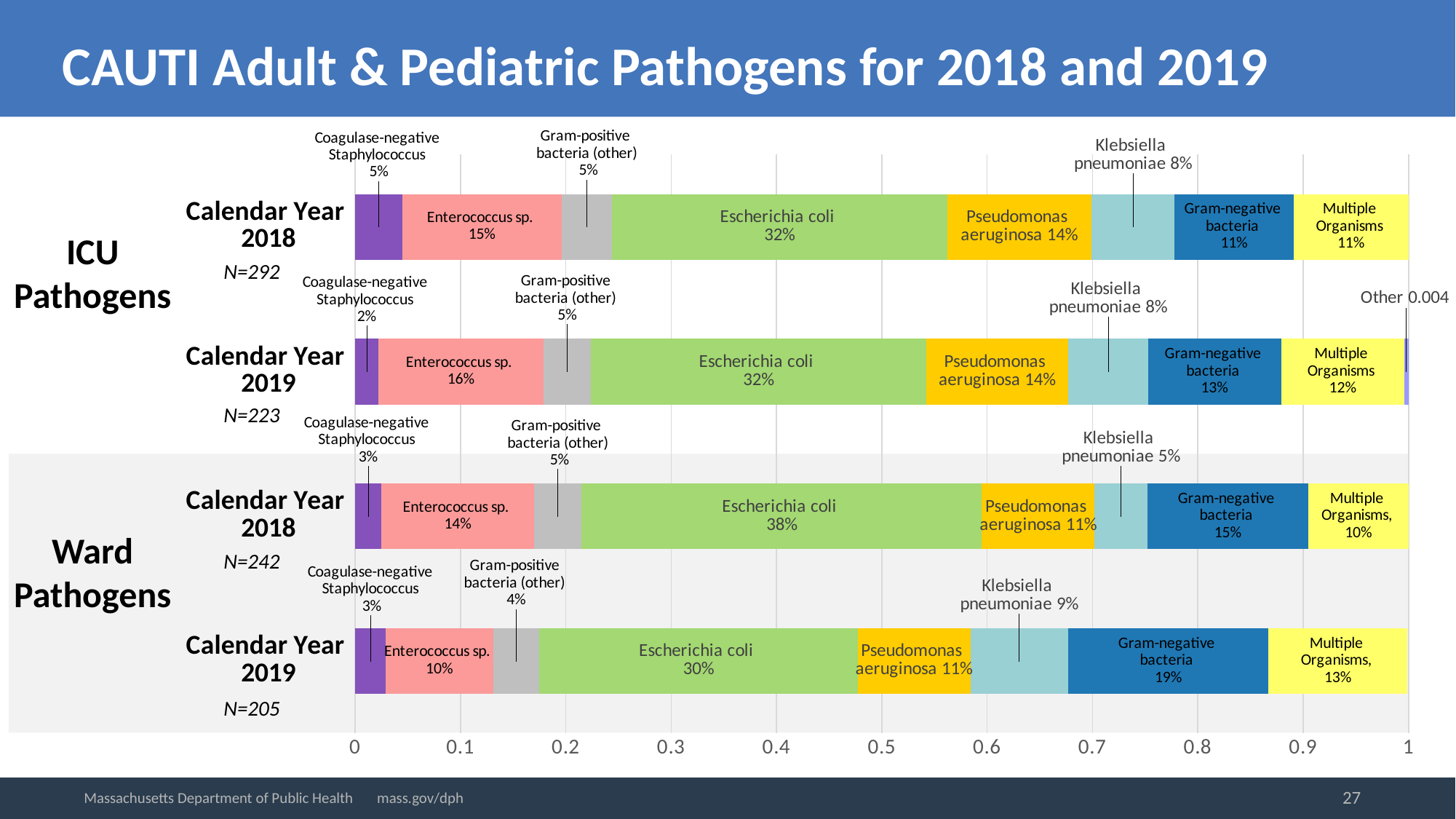
What is the N value for Ward pathogens in Calendar Year 2019? N=205 How many stacked bars are shown in the chart? 4 What share of Ward pathogens in Calendar Year 2019 was Gram-negative bacteria? 19% What kind of chart is shown on the slide? Stacked bar chart What is the title of the slide? CAUTI Adult & Pediatric Pathogens for 2018 and 2019 What is the value labelled for 'Other' in the ICU Calendar Year 2019 bar? 0.004 Which is larger: the Pseudomonas aeruginosa share for ICU Calendar Year 2018 or for Ward Calendar Year 2018? ICU Calendar Year 2018 Which pathogen has the largest share in the Ward Calendar Year 2018 bar? Escherichia coli What percentage of Ward pathogens in Calendar Year 2019 was Klebsiella pneumoniae? 9% What is the difference in percentage points between the Enterococcus sp. share for ICU Calendar Year 2019 and Ward Calendar Year 2019? 6 percentage points What percentage of ICU pathogens in Calendar Year 2018 was Escherichia coli? 32% What percentage of ICU pathogens in Calendar Year 2019 was Coagulase-negative Staphylococcus? 2%